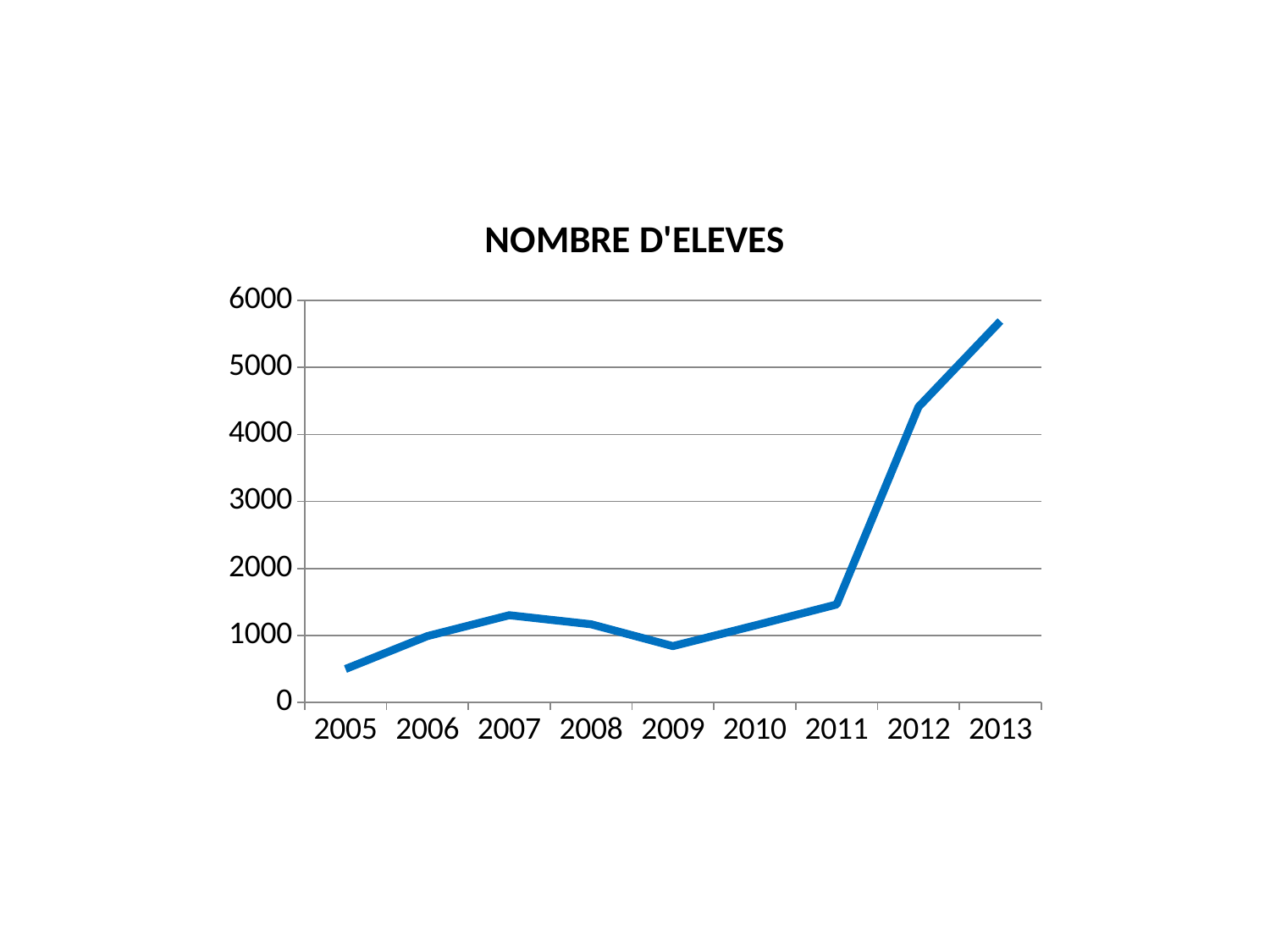
How many years are plotted on the x axis? 9 Is the value for 2012 greater or less than 3000? greater What kind of chart is shown on the slide? Line chart Which year has the lowest number of students? 2005 Which year has a larger value, 2007 or 2009? 2007 Is the value for 2013 greater or less than 5000? greater Does the number of students overall rise or fall from 2005 to 2013? Rise What is the title of the chart? NOMBRE D'ELEVES Which year has the highest number of students? 2013 Is the value for 2011 greater or less than 2000? less Which year has a larger value, 2011 or 2012? 2012